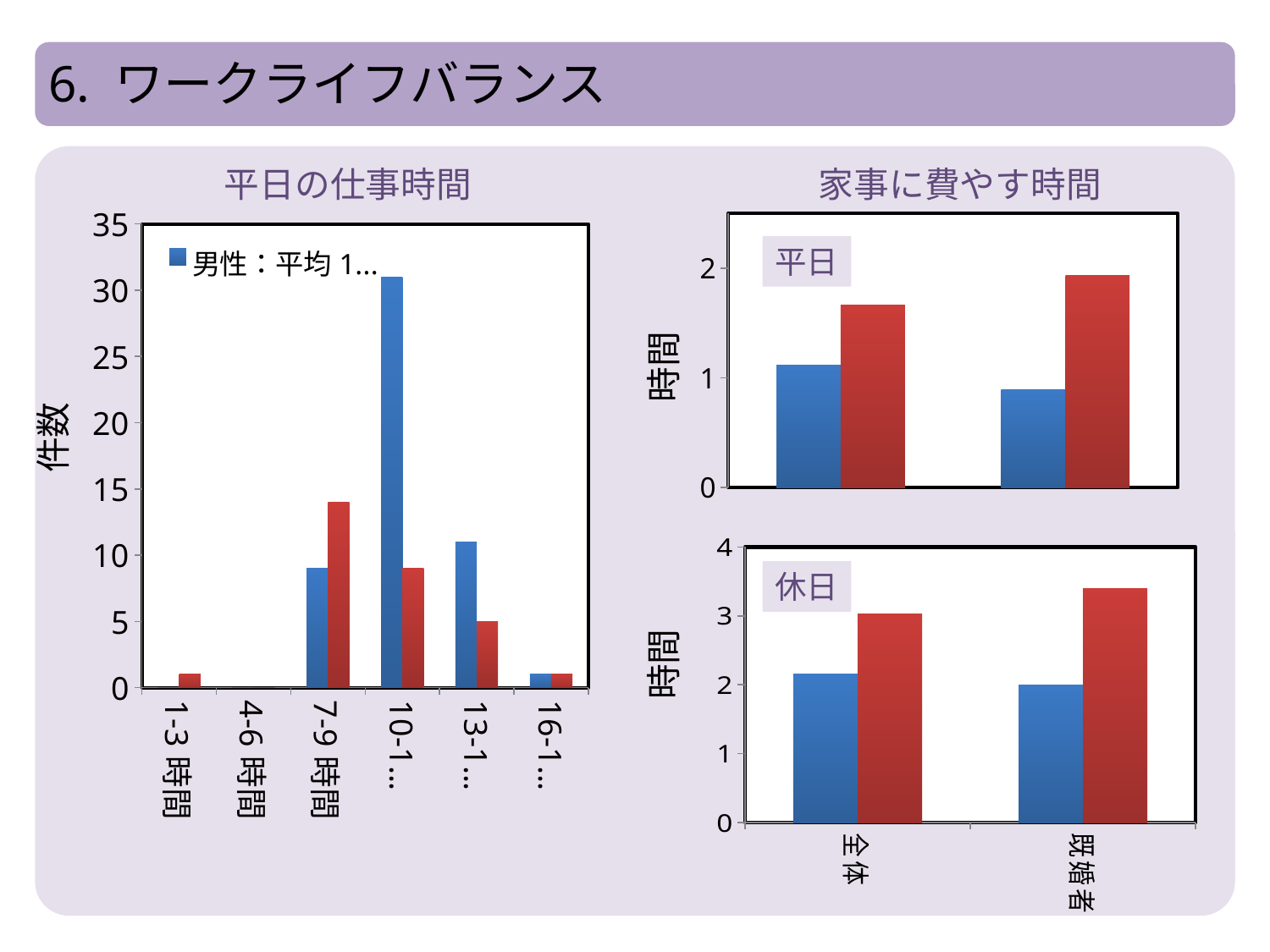
What is the y-axis label of the 平日の仕事時間 chart? 件数 In the 平日の仕事時間 chart, is the blue bar for 7-9 時間 greater or less than 10? less How many categories are shown on the x axis of the 平日の仕事時間 chart? 6 In the 休日 chart under 家事に費やす時間, is the red bar for 既婚者 greater or less than 3? greater In the 休日 chart under 家事に費やす時間, which is larger for 全体, the blue bar or the red bar? the red bar In the 平日の仕事時間 chart, is the tallest blue bar greater or less than 30? greater How many categories are shown on the x axis of the 休日 chart? 2 What kind of chart is the 平日の仕事時間 chart? bar chart In the 平日の仕事時間 chart, which is larger for 7-9 時間, the blue bar or the red bar? the red bar